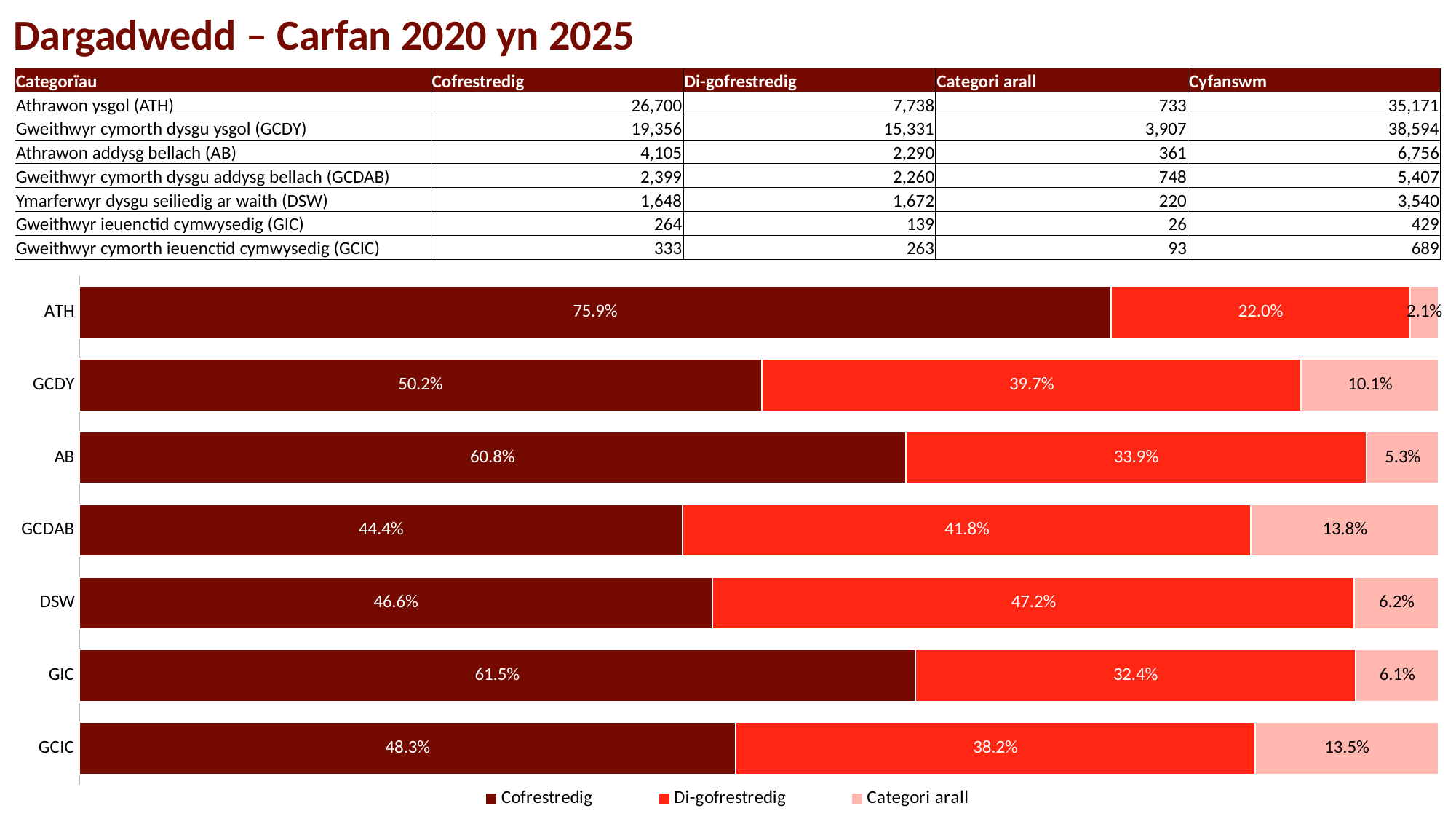
What kind of chart is shown on the slide? Stacked bar chart What is the difference between the Cofrestredig and Di-gofrestredig shares for ATH? 53.9 percentage points What is the Categori arall value for GCIC in the chart? 13.5% What is the Cofrestredig value for ATH in the chart? 75.9% Which category has the highest Categori arall share in the chart? GCDAB How many categories are shown in the chart? 7 Which category has the highest Cofrestredig share in the chart? ATH Which category has the lowest Cofrestredig share in the chart? GCDAB What is the Di-gofrestredig value for GCDAB in the chart? 41.8% For DSW, which is larger: the Cofrestredig share or the Di-gofrestredig share? Di-gofrestredig Which series is shown in the lightest pink colour in the chart? Categori arall How many series does the chart legend list? 3